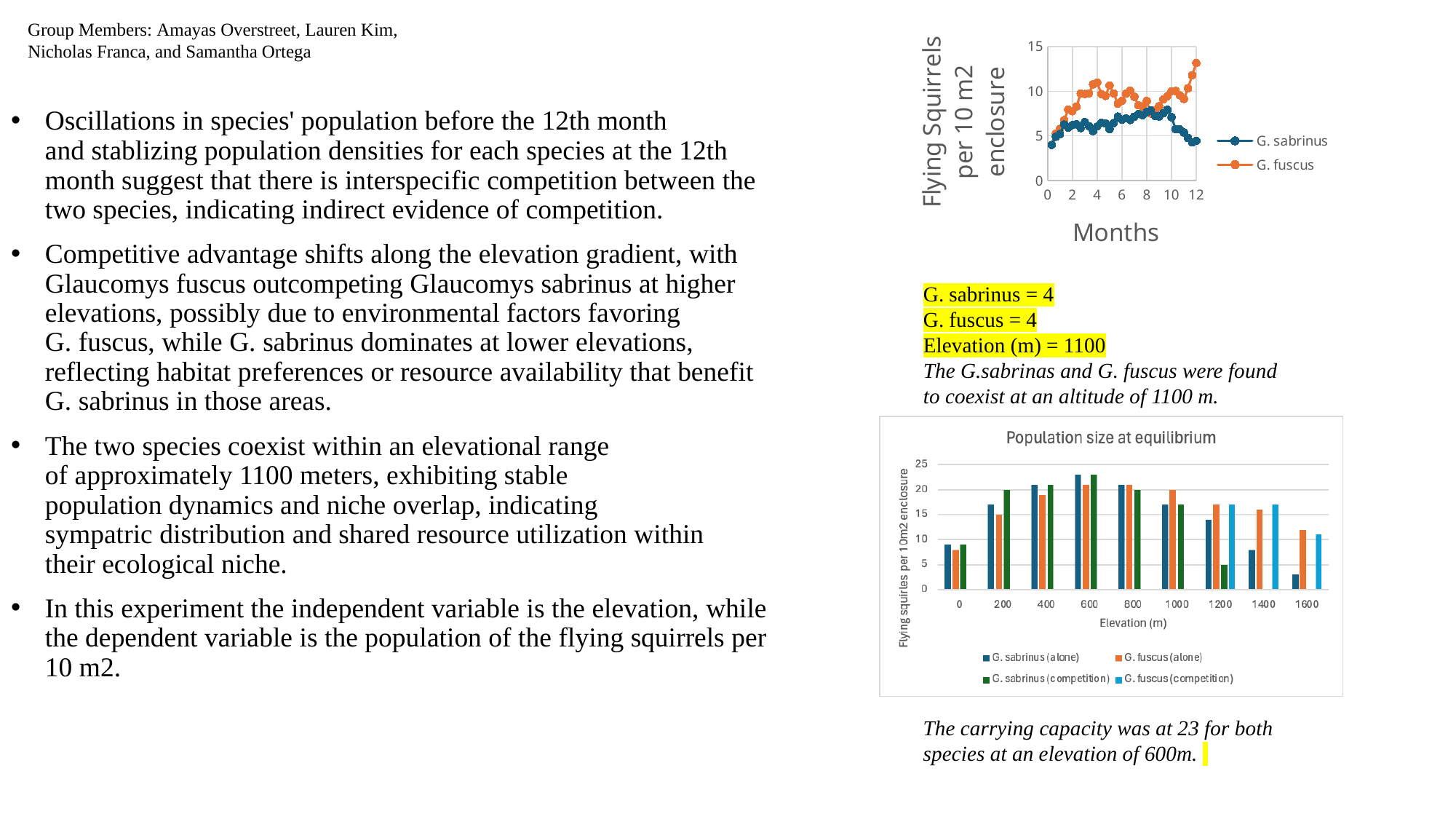
In the 'Population size at equilibrium' chart, is the value for G. fuscus (alone) at 1000 m greater or less than 15? greater In the 'Population size at equilibrium' chart, at which elevation is G. sabrinus (alone) highest? 600 In the top line chart, which species has the higher value at month 12? G. fuscus What kind of chart is the 'Population size at equilibrium' chart? bar chart In the top line chart, how many series does the legend list? 2 In the 'Population size at equilibrium' chart, at 1200 m, which is larger: G. sabrinus (competition) or G. fuscus (competition)? G. fuscus (competition) In the 'Population size at equilibrium' chart, how many elevation categories are shown on the x axis? 9 In the top line chart, is the value for G. fuscus at month 12 greater or less than 10? greater In the 'Population size at equilibrium' chart, do the values for G. sabrinus (alone) rise or fall from 600 m to 1600 m? fall What kind of chart is the top chart showing Flying Squirrels per 10 m2 enclosure against Months? line chart In the 'Population size at equilibrium' chart, is the value for G. sabrinus (alone) at 1600 m greater or less than 5? less In the 'Population size at equilibrium' chart, how many series does the legend list? 4